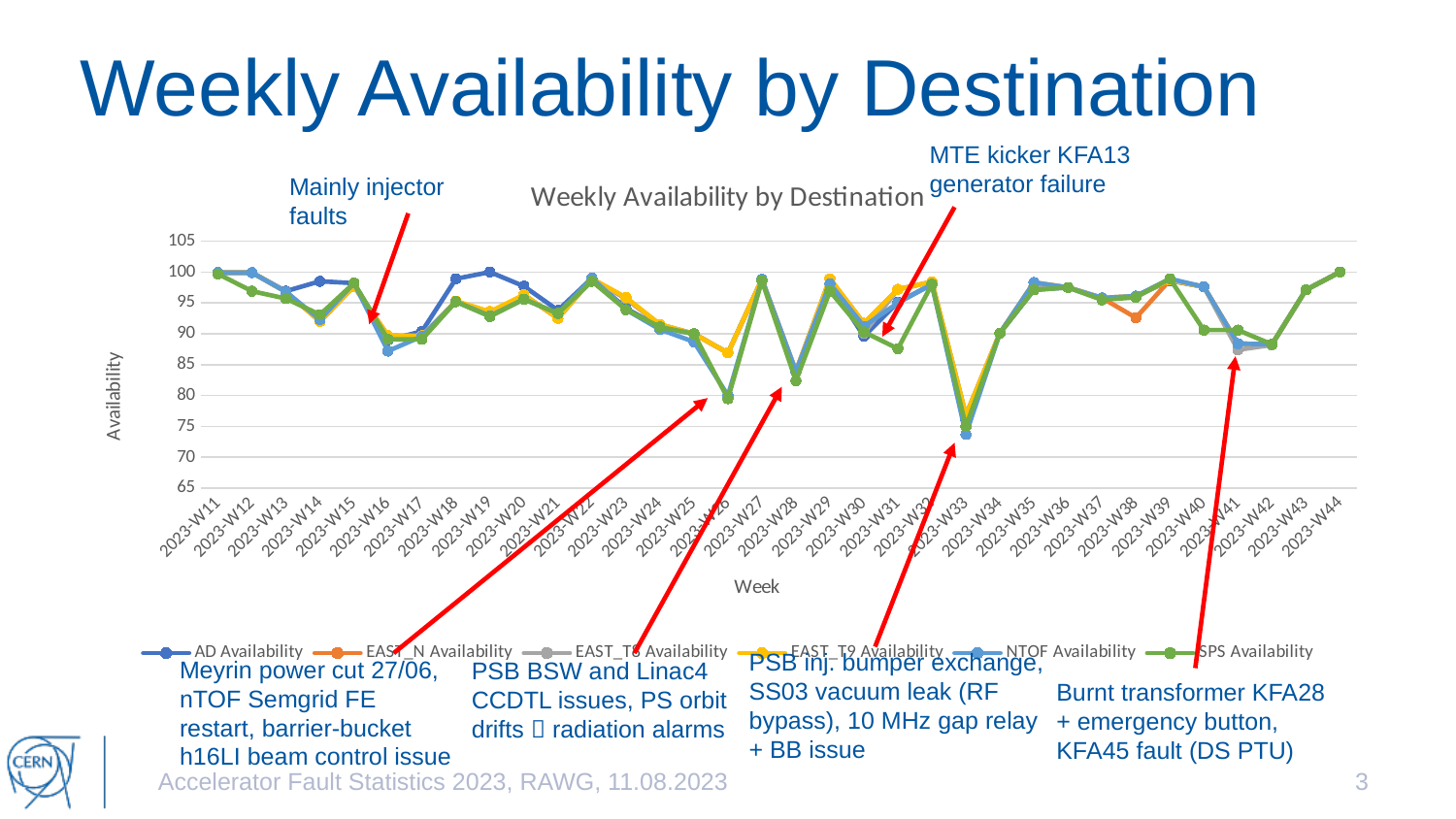
How many weeks are plotted along the x axis of the chart? 34 What is the title of the chart? Weekly Availability by Destination Is the SPS Availability value for 2023-W44 greater or less than 95? greater In which week does the SPS Availability series reach its lowest value? 2023-W33 Is the SPS Availability value for 2023-W33 greater or less than 80? less Is the NTOF Availability value for 2023-W16 greater or less than 90? less What is the label of the vertical axis of the chart? Availability Which is larger for SPS Availability: the value in 2023-W27 or the value in 2023-W28? 2023-W27 What kind of chart is shown on the slide? line chart How many series does the chart legend list? 6